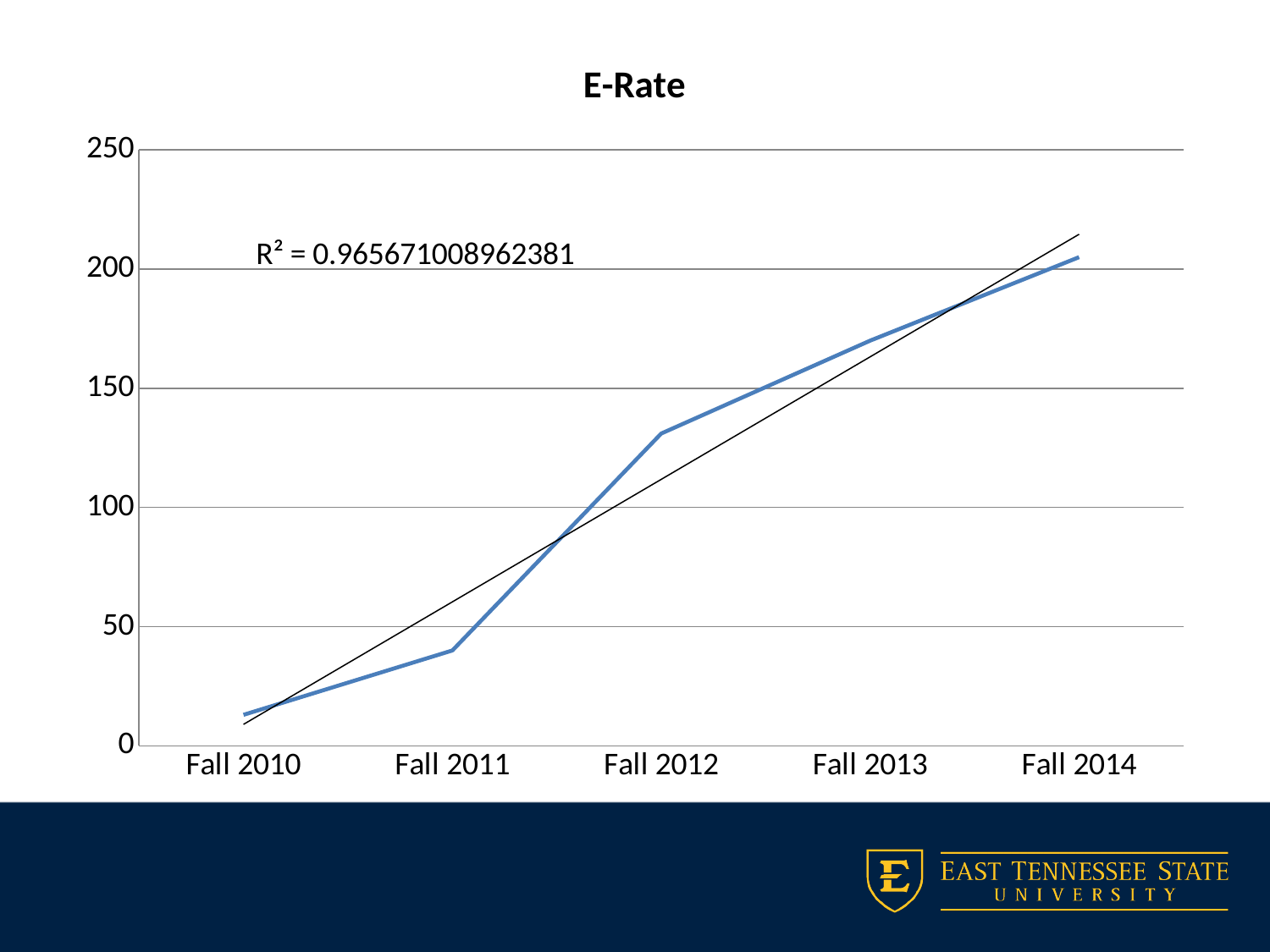
Is the value for Fall 2012 greater or less than 100? greater What kind of chart is shown on the slide? line chart Which is larger, the value for Fall 2012 or the value for Fall 2011? Fall 2012 Is the value for Fall 2011 greater or less than 50? less Which period has the lowest value? Fall 2010 Is the value for Fall 2014 greater or less than 200? greater Which period has the highest value? Fall 2014 How many data points are plotted along the x axis? 5 Do the values rise or fall from Fall 2010 to Fall 2014? rise What R² value is printed on the chart for the trendline? 0.965671008962381 What is the title of the chart? E-Rate